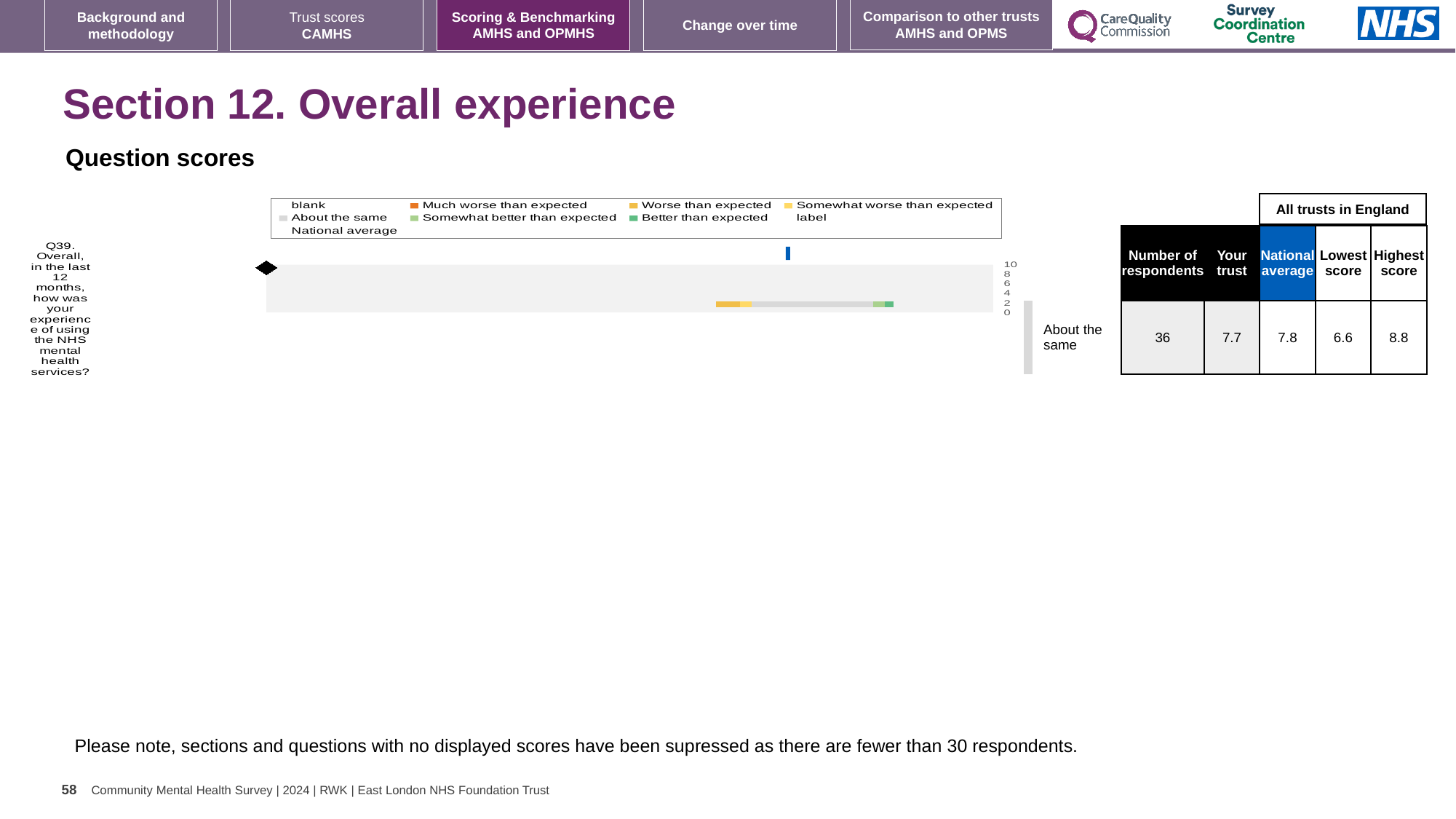
What is the 'Your trust' score for Q39 (overall experience of using NHS mental health services)? 7.7 What is the highest value shown on the chart's score axis? 10 What is the national average score for Q39? 7.8 What is the highest score among all trusts in England for Q39? 8.8 What is the difference between the highest score and the lowest score for Q39? 2.2 What kind of chart is shown on the slide? bar chart How many survey questions are plotted on the chart? 1 How many respondents answered Q39? 36 Which is larger for Q39: the 'Your trust' score or the national average? National average By how much does the national average exceed the 'Your trust' score for Q39? 0.1 What benchmark category is the trust's Q39 result placed in? About the same What is the lowest score among all trusts in England for Q39? 6.6